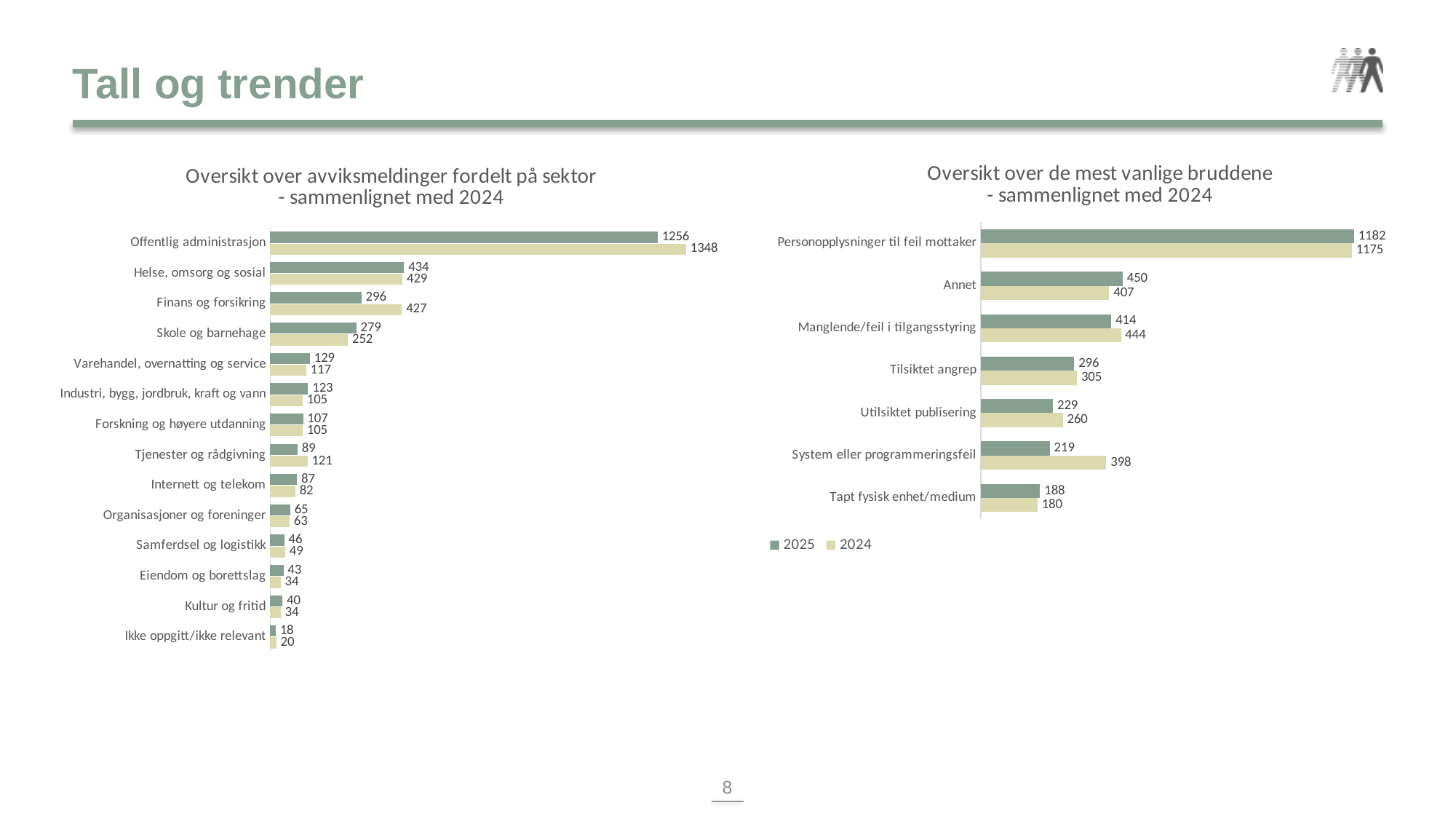
In the chart 'Oversikt over de mest vanlige bruddene', what is the difference between the 2024 and 2025 values for System eller programmeringsfeil? 179 In the chart 'Oversikt over avviksmeldinger fordelt på sektor', how many sectors are listed? 14 In the chart 'Oversikt over avviksmeldinger fordelt på sektor', which sector has the lowest 2025 value? Ikke oppgitt/ikke relevant In the chart 'Oversikt over de mest vanlige bruddene', what is the 2024 value for System eller programmeringsfeil? 398 In the chart 'Oversikt over de mest vanlige bruddene', what is the 2025 value for Annet? 450 In the chart 'Oversikt over de mest vanlige bruddene', which category has the highest 2025 value? Personopplysninger til feil mottaker In the chart 'Oversikt over avviksmeldinger fordelt på sektor', is the 2025 value for Tjenester og rådgivning larger or smaller than its 2024 value? smaller What type of chart is 'Oversikt over de mest vanlige bruddene'? Bar chart In the chart 'Oversikt over avviksmeldinger fordelt på sektor', what is the difference between the 2024 and 2025 values for Offentlig administrasjon? 92 In the chart 'Oversikt over avviksmeldinger fordelt på sektor', what is the 2025 value for Offentlig administrasjon? 1256 In the chart 'Oversikt over de mest vanlige bruddene', how many series does the legend list? 2 In the chart 'Oversikt over avviksmeldinger fordelt på sektor', what is the 2024 value for Finans og forsikring? 427